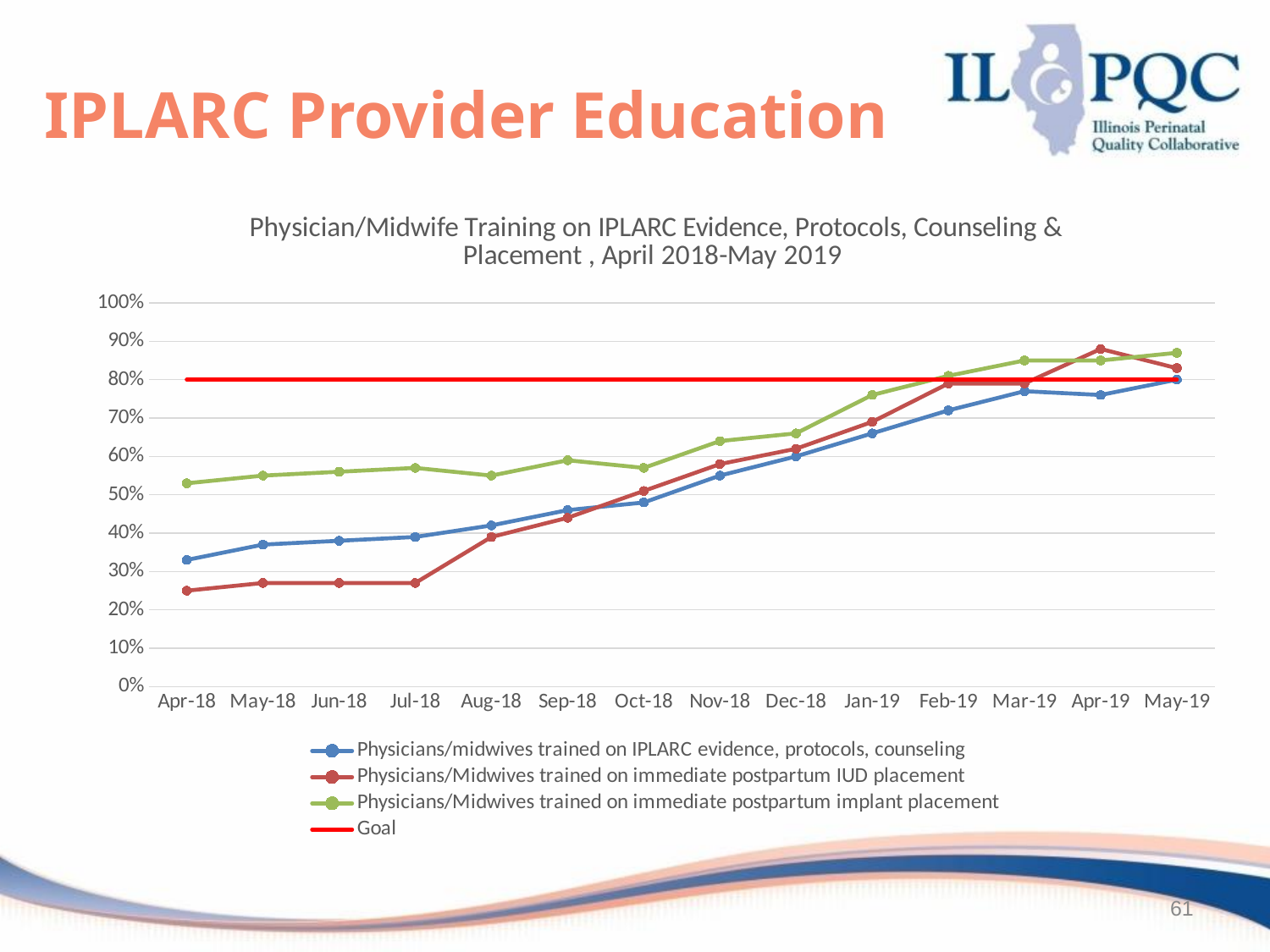
Is the value for Physicians/Midwives trained on immediate postpartum implant placement in Apr-18 greater or less than 50%? greater Which series has the highest value in Apr-18? Goal How many series does the legend list? 4 Do the values for Physicians/midwives trained on IPLARC evidence, protocols, counseling generally rise or fall from Apr-18 to May-19? rise What colour is the Goal line in the chart? red Which series has the lowest value in Apr-18? Physicians/Midwives trained on immediate postpartum IUD placement What kind of chart is shown on the slide? line chart Is the value for Physicians/Midwives trained on immediate postpartum implant placement in May-19 greater or less than 80%? greater How many months are shown along the x axis? 14 Is the value for Physicians/Midwives trained on immediate postpartum IUD placement in Apr-18 greater or less than 30%? less What value does the Goal line sit at? 80% In Apr-19, which is larger: Physicians/Midwives trained on immediate postpartum IUD placement or Physicians/midwives trained on IPLARC evidence, protocols, counseling? Physicians/Midwives trained on immediate postpartum IUD placement